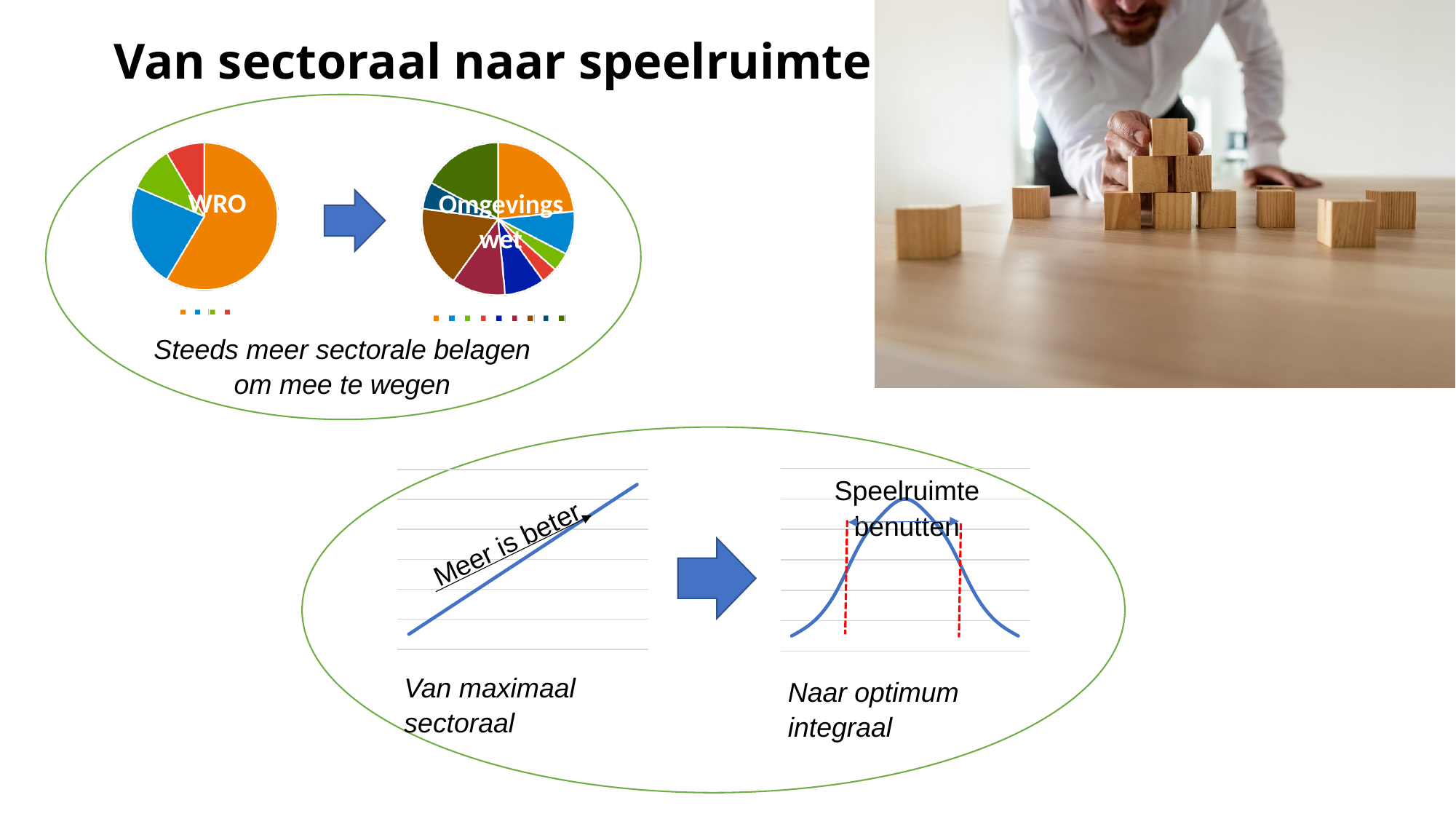
Does the line in the 'Meer is beter' chart rise or fall along the x axis? rises What label is printed on the right pie chart? Omgevingswet What kind of chart is the 'Meer is beter' chart? line chart Which colour slice is the largest in the Omgevingswet pie chart? orange How many entries does the legend under the WRO pie chart show? 4 Which colour slice is the smallest in the WRO pie chart? red Which pie chart has more slices, WRO or Omgevingswet? Omgevingswet How many slices does the WRO pie chart have? 4 What label is printed on the left pie chart? WRO Does the curve in the 'Speelruimte benutten' chart rise, fall, or rise then fall along the x axis? rise then fall Which colour slice is the largest in the WRO pie chart? orange What kind of chart is the WRO chart? pie chart